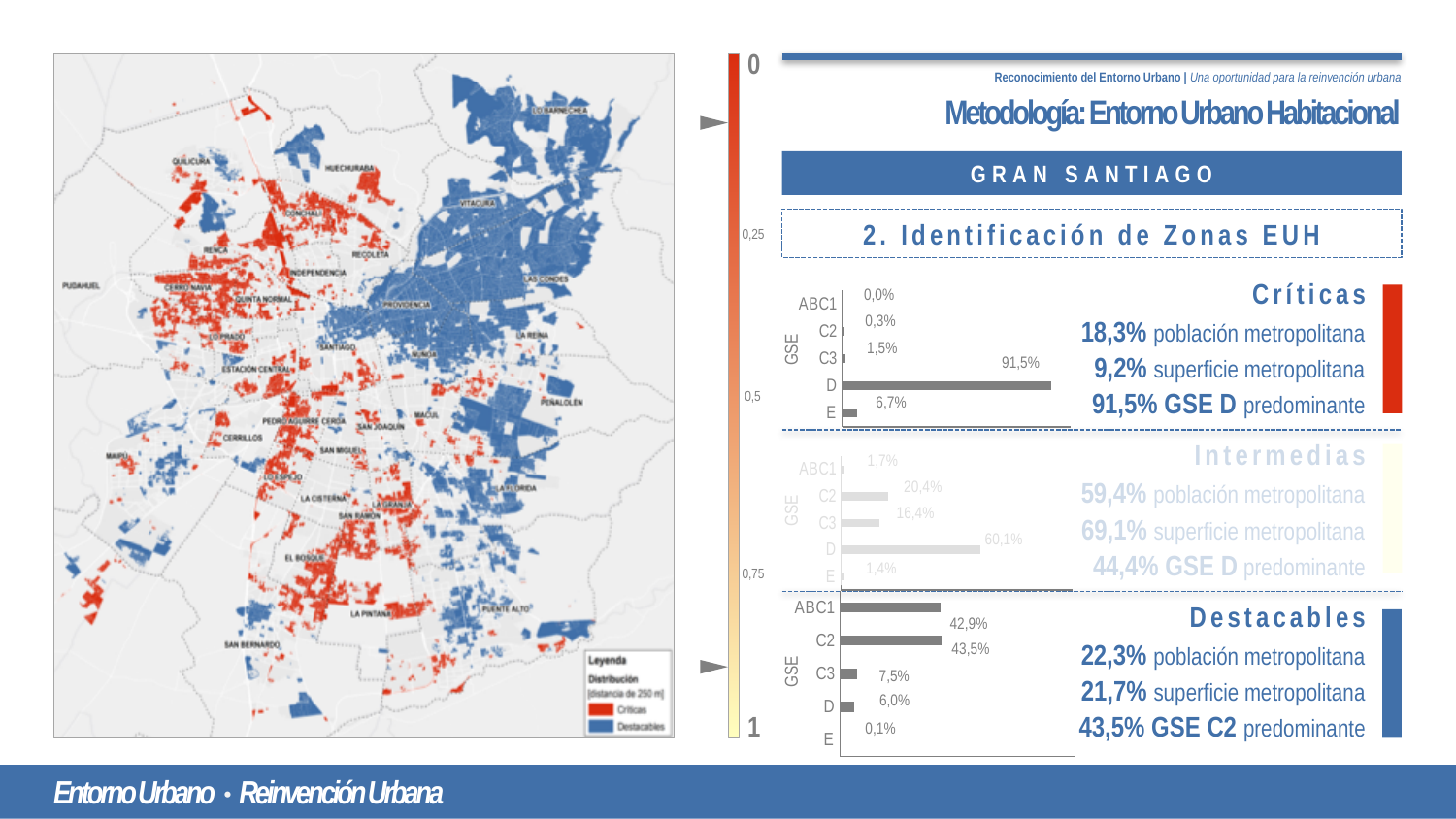
In the Críticas chart, what is the value for GSE D? 91,5% In the Destacables chart, what is the difference between the values for C3 and D? 1,5% In the Críticas chart, what is the value for GSE E? 6,7% In the Intermedias chart, what is the value for GSE D? 60,1% How many GSE categories are shown in the Críticas chart? 5 In the Intermedias chart, which GSE category has the highest value? D In the Destacables chart, what is the value for GSE ABC1? 42,9% In the Críticas chart, which GSE category has the lowest value? ABC1 In the Destacables chart, what is the value for GSE C2? 43,5% In the Destacables chart, which GSE category has the lowest value? E In the Destacables chart, which is larger, the value for C3 or the value for D? C3 What kind of chart is used to show the GSE distribution for Destacables? Bar chart